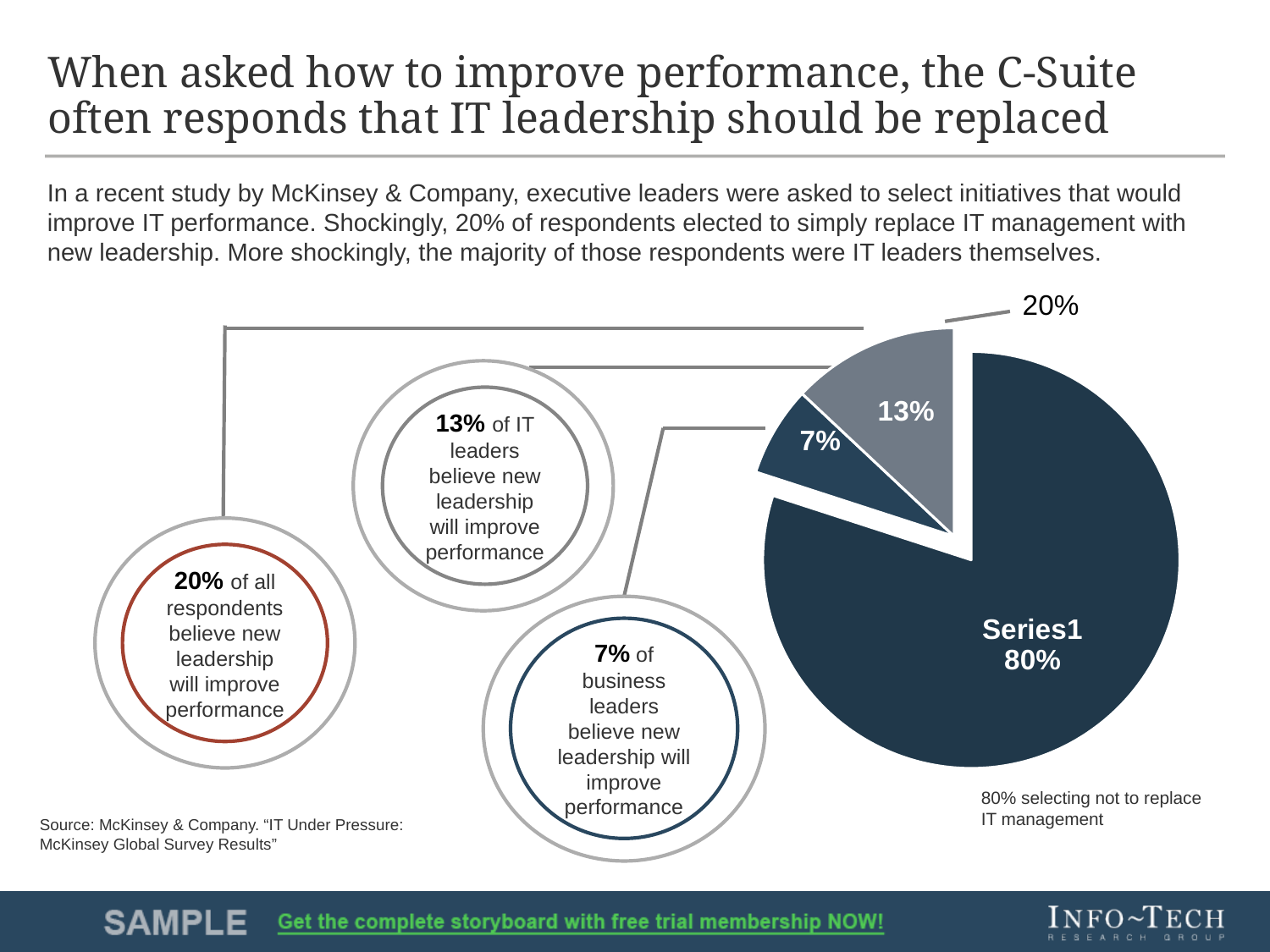
Which is larger in the pie chart: the slice for IT leaders who believe new leadership will improve performance, or the slice for business leaders? IT leaders (13%) What kind of chart is shown on the slide? pie chart Is the value of the largest slice in the pie chart greater or less than 50%? greater What share of the pie chart represents respondents selecting not to replace IT management? 80% What do the two smaller slices of the pie chart (13% and 7%) add up to? 20% What percentage of all respondents believe new leadership will improve performance, according to the annotation on the pie chart? 20% What is the difference between the 13% slice and the 7% slice in the pie chart? 6% What label is printed on the largest slice of the pie chart? Series1 80% What is the value of the largest slice in the pie chart? 80% What percentage of business leaders believe new leadership will improve performance? 7% What is the value of the smallest slice in the pie chart? 7% How many slices does the pie chart have? 3